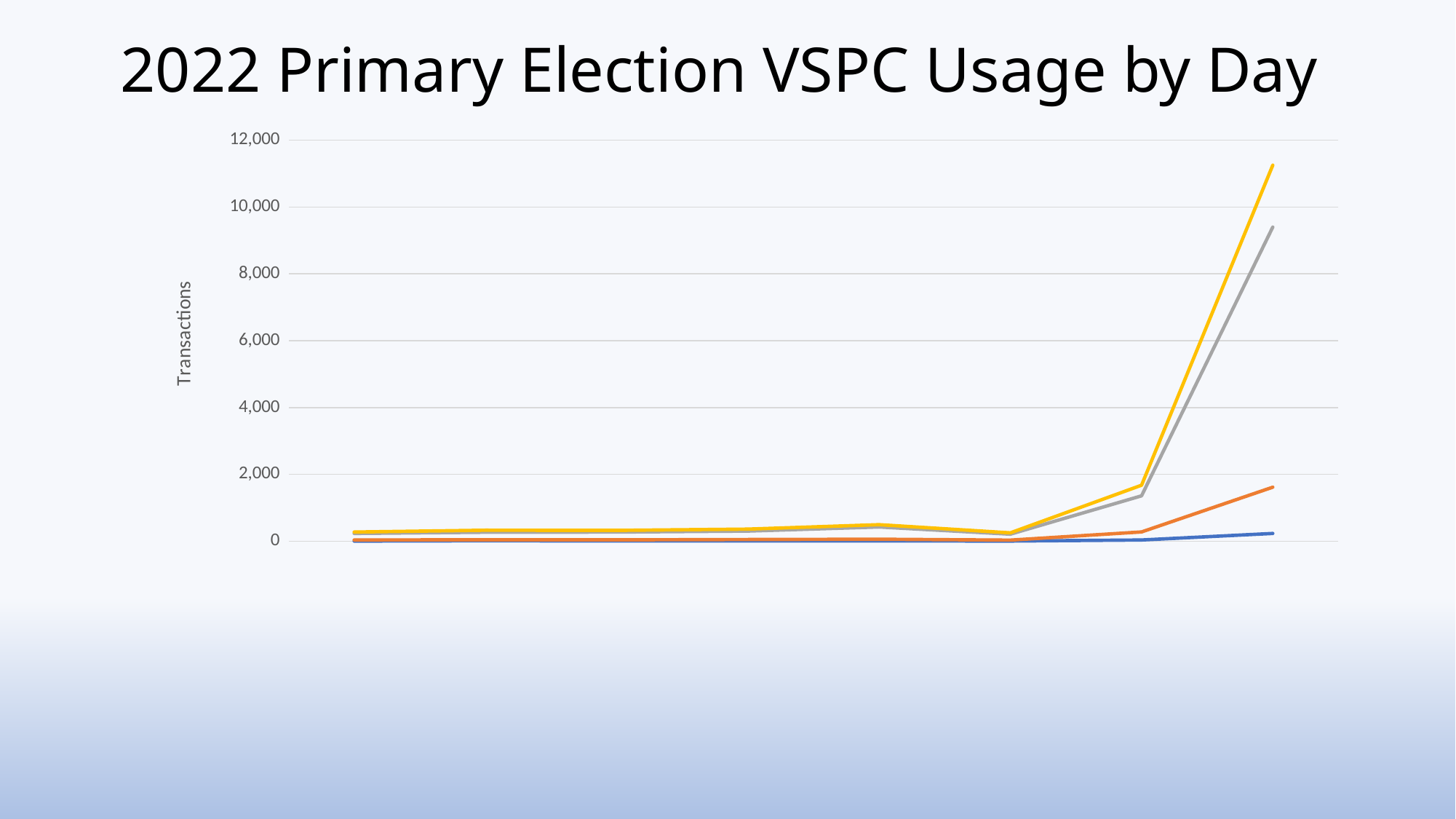
Is the final value of the gray line greater or less than 8,000? greater What is the title of the chart? 2022 Primary Election VSPC Usage by Day Do the lines rise or fall toward the right end of the chart? rise Is the final value of the yellow line greater or less than 10,000? greater Which line stays lowest at the right end of the chart? the blue line Which line reaches the highest value at the right end of the chart? the yellow line Is the final value of the gray line greater or less than 10,000? less How many lines are plotted on the chart? 4 What kind of chart is shown on the slide? line chart At the right end of the chart, which is larger: the yellow line or the gray line? the yellow line What is the label on the vertical axis of the chart? Transactions